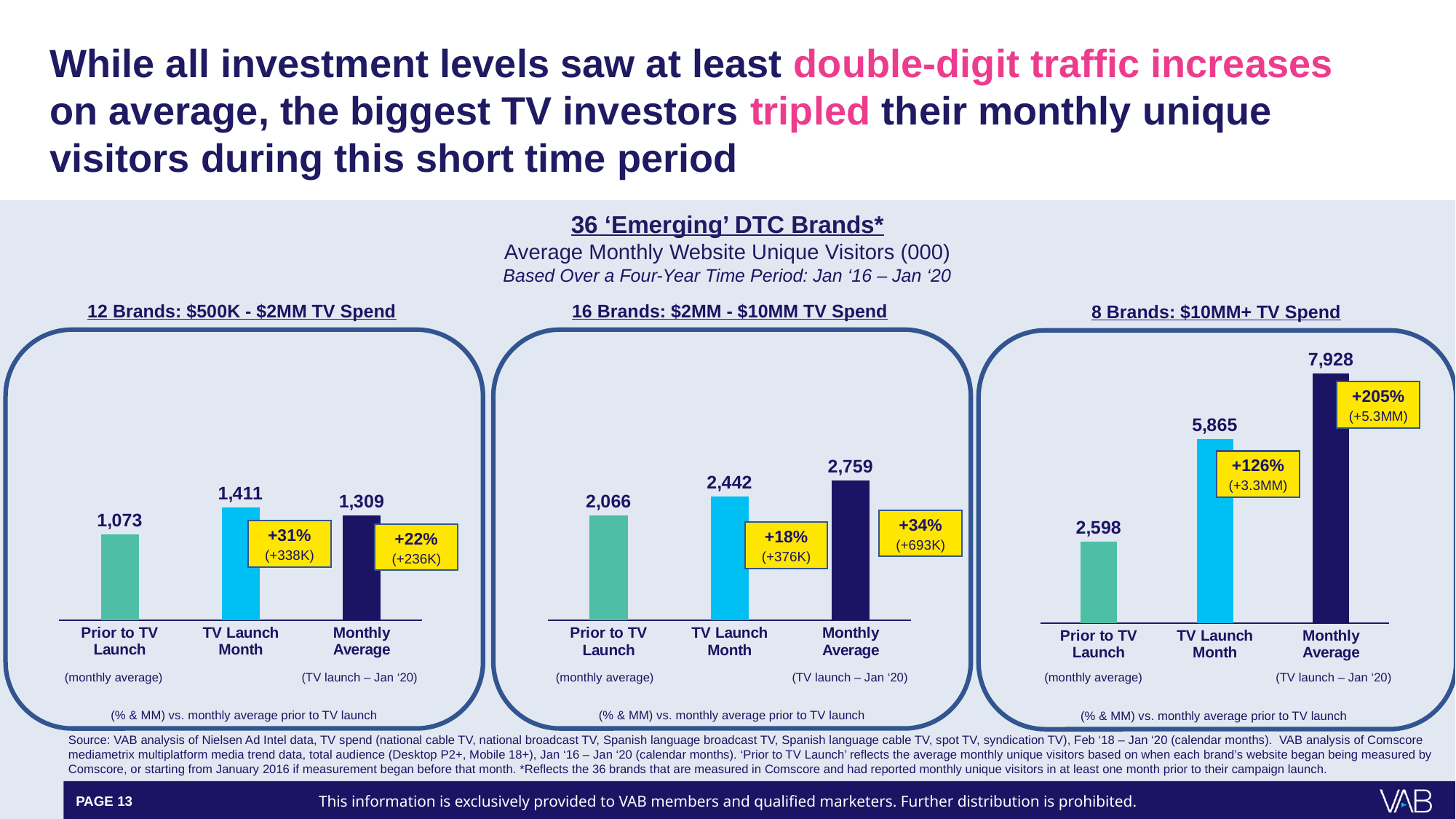
In the '8 Brands: $10MM+ TV Spend' chart, which category has the lowest value? Prior to TV Launch In the '12 Brands: $500K - $2MM TV Spend' chart, which category has the highest value? TV Launch Month In the '16 Brands: $2MM - $10MM TV Spend' chart, what is the value for Prior to TV Launch? 2,066 In the '12 Brands: $500K - $2MM TV Spend' chart, what is the value for TV Launch Month? 1,411 In the '8 Brands: $10MM+ TV Spend' chart, what is the difference between TV Launch Month and Prior to TV Launch? 3,267 What kind of chart is the '16 Brands: $2MM - $10MM TV Spend' chart? Bar chart In the '12 Brands: $500K - $2MM TV Spend' chart, which is larger: TV Launch Month or Monthly Average? TV Launch Month In the '8 Brands: $10MM+ TV Spend' chart, what percentage increase is shown for Monthly Average versus the monthly average prior to TV launch? +205% In the '16 Brands: $2MM - $10MM TV Spend' chart, what is the difference between Monthly Average and Prior to TV Launch? 693 In the '8 Brands: $10MM+ TV Spend' chart, what is the value for Monthly Average? 7,928 In the '16 Brands: $2MM - $10MM TV Spend' chart, which is larger: TV Launch Month or Monthly Average? Monthly Average How many bars are in the '8 Brands: $10MM+ TV Spend' chart? 3